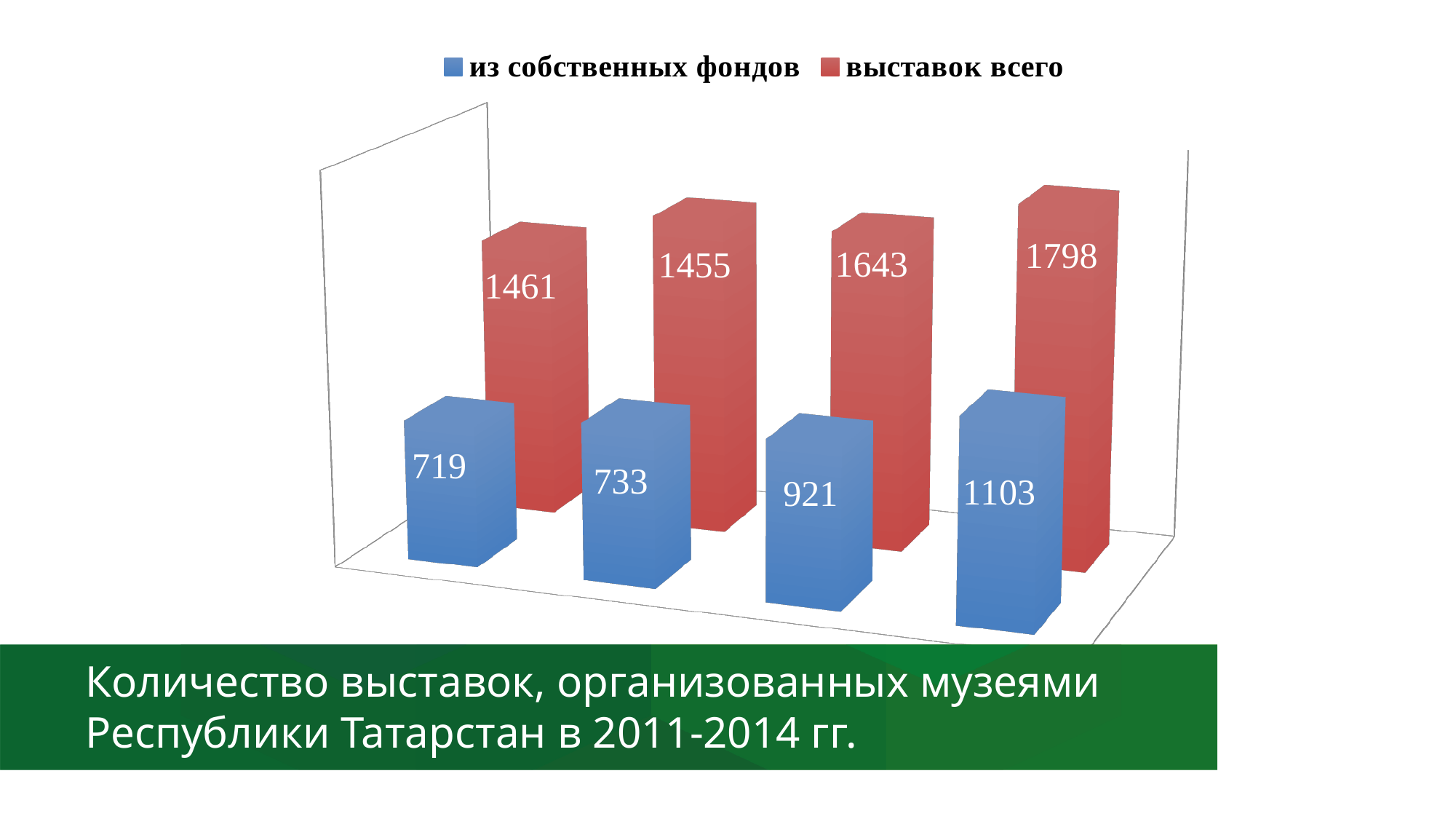
Which is larger: the first red bar (1461) or the second red bar (1455) in the 'выставок всего' series? The first red bar (1461) What is the value of the rightmost red bar in the 'выставок всего' series? 1798 What kind of chart is shown on the slide? Bar chart What is the difference between the rightmost 'выставок всего' bar (1798) and the rightmost 'из собственных фондов' bar (1103)? 695 How many series does the legend list? 2 What is the highest value in the 'выставок всего' series? 1798 What is the value of the third blue bar from the left ('из собственных фондов')? 921 What is the value of the first (leftmost) blue bar in the 'из собственных фондов' series? 719 How many groups of bars are plotted on the chart? 4 What is the lowest value in the 'выставок всего' series? 1455 Do the values of the 'из собственных фондов' series rise or fall from left to right? Rise What is the lowest value in the 'из собственных фондов' series? 719